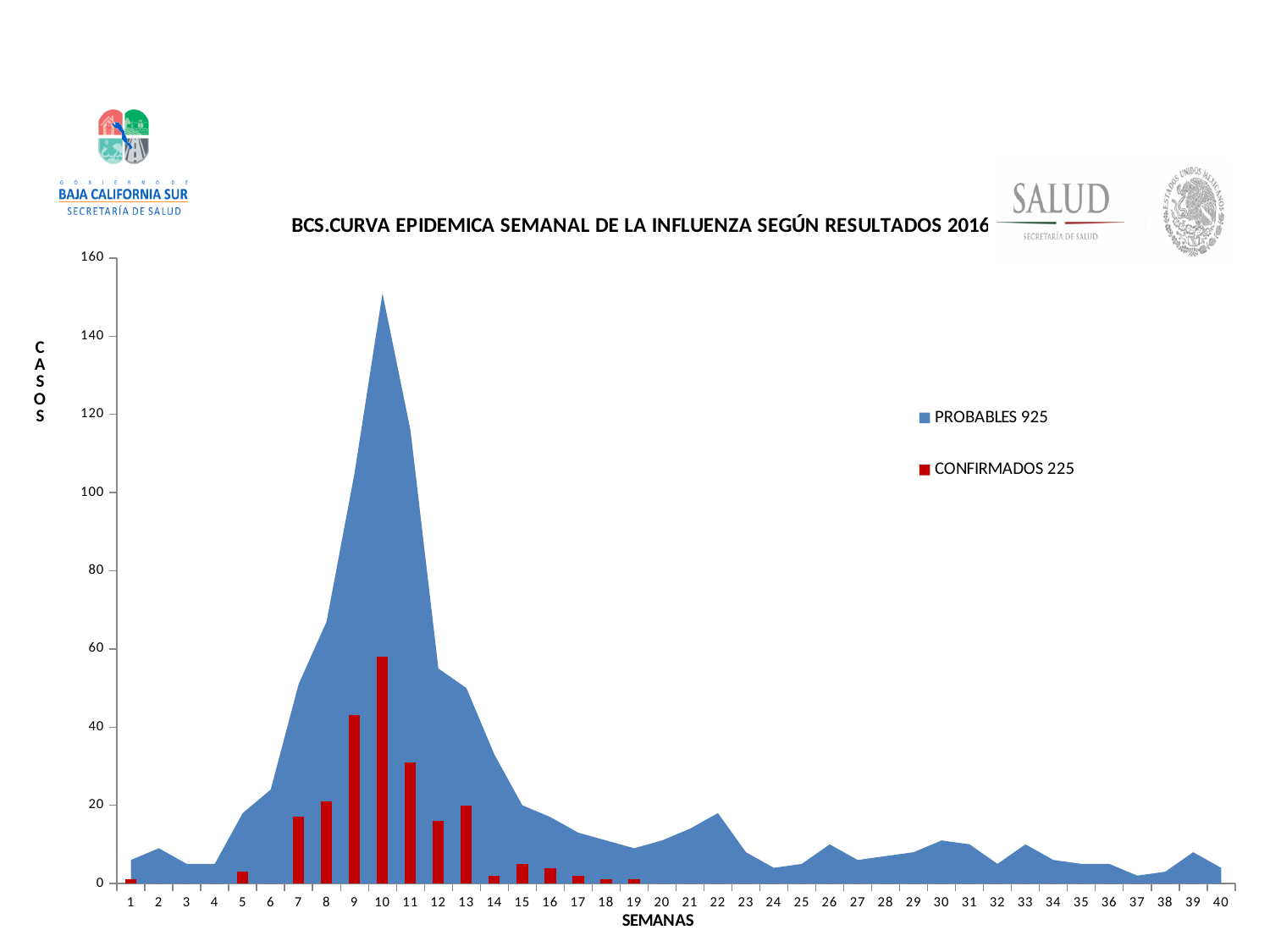
Is the value of PROBABLES in week 10 greater or less than 140? greater What kind of chart is used to plot the CONFIRMADOS series? bar chart What total is shown next to CONFIRMADOS in the legend? 225 In which week do the PROBABLES cases reach their highest value? 10 What total is shown next to PROBABLES in the legend? 925 Which week has more CONFIRMADOS cases, week 9 or week 11? week 9 How many series does the legend list? 2 What is the title of the chart? BCS.CURVA EPIDEMICA SEMANAL DE LA INFLUENZA SEGÚN RESULTADOS 2016 How many weeks (semanas) are shown on the x axis? 40 Is the value of CONFIRMADOS in week 11 greater or less than 40? less In which week do the CONFIRMADOS cases reach their highest value? 10 Do the PROBABLES cases rise or fall from week 10 to week 20? fall